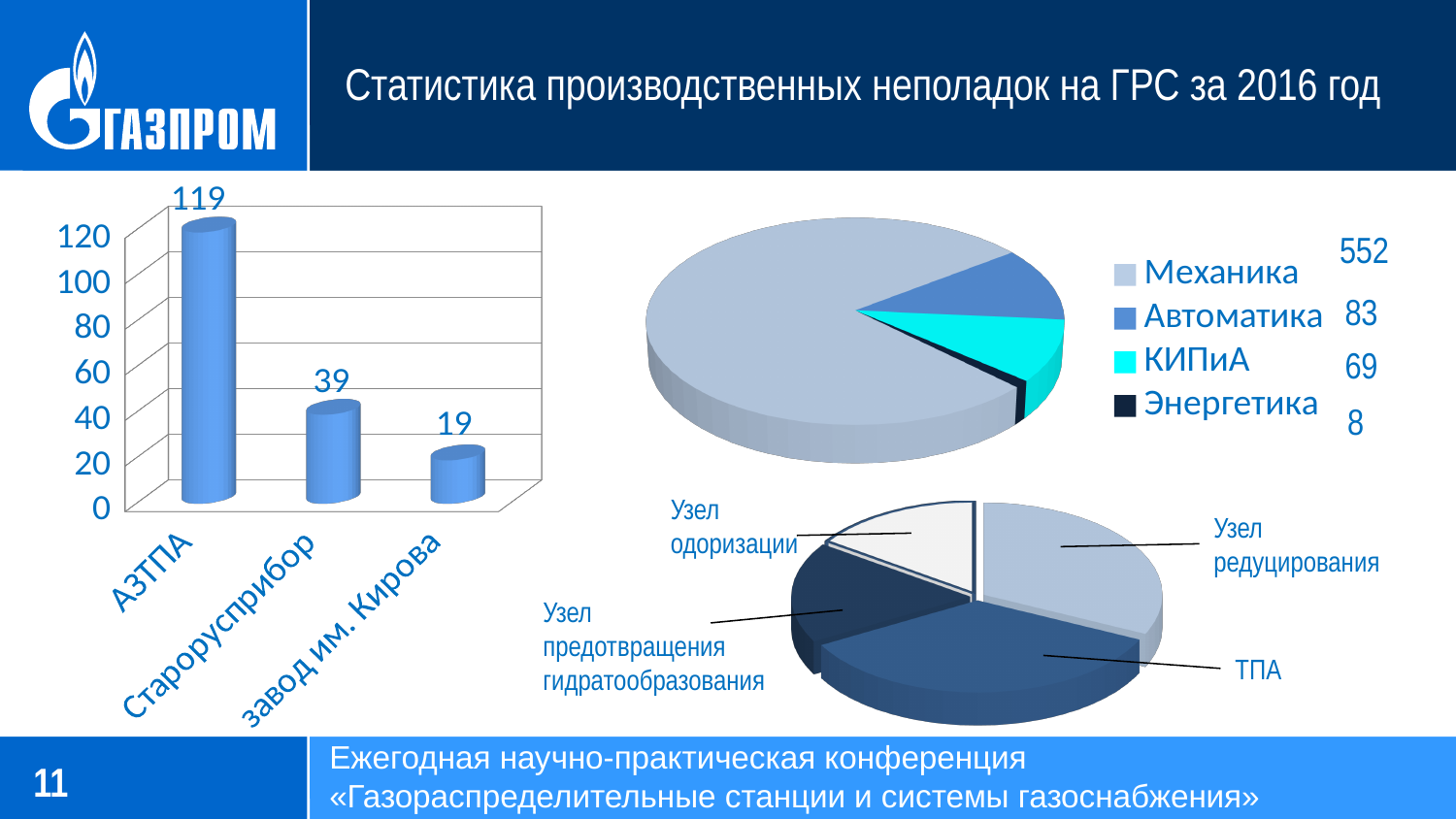
How many entries does the legend of the pie chart at the top right list? 4 In the pie chart at the bottom right, how many slices are labelled? 4 In the bar chart on the left, what is the difference between the values for АЗТПА and завод им. Кирова? 100 In the pie chart at the top right, which category has the largest value? Механика In the bar chart on the left, how many categories are shown? 3 In the bar chart on the left, what is the value for АЗТПА? 119 In the pie chart at the top right, what is the value for Автоматика? 83 In the bar chart on the left, what is the value for Старорусприбор? 39 In the pie chart at the top right, which is larger: КИПиА or Энергетика? КИПиА In the bar chart on the left, which category has the lowest value? завод им. Кирова In the pie chart at the top right, what is the difference between the values for Автоматика and КИПиА? 14 What kind of chart is the chart on the left of the slide? bar chart